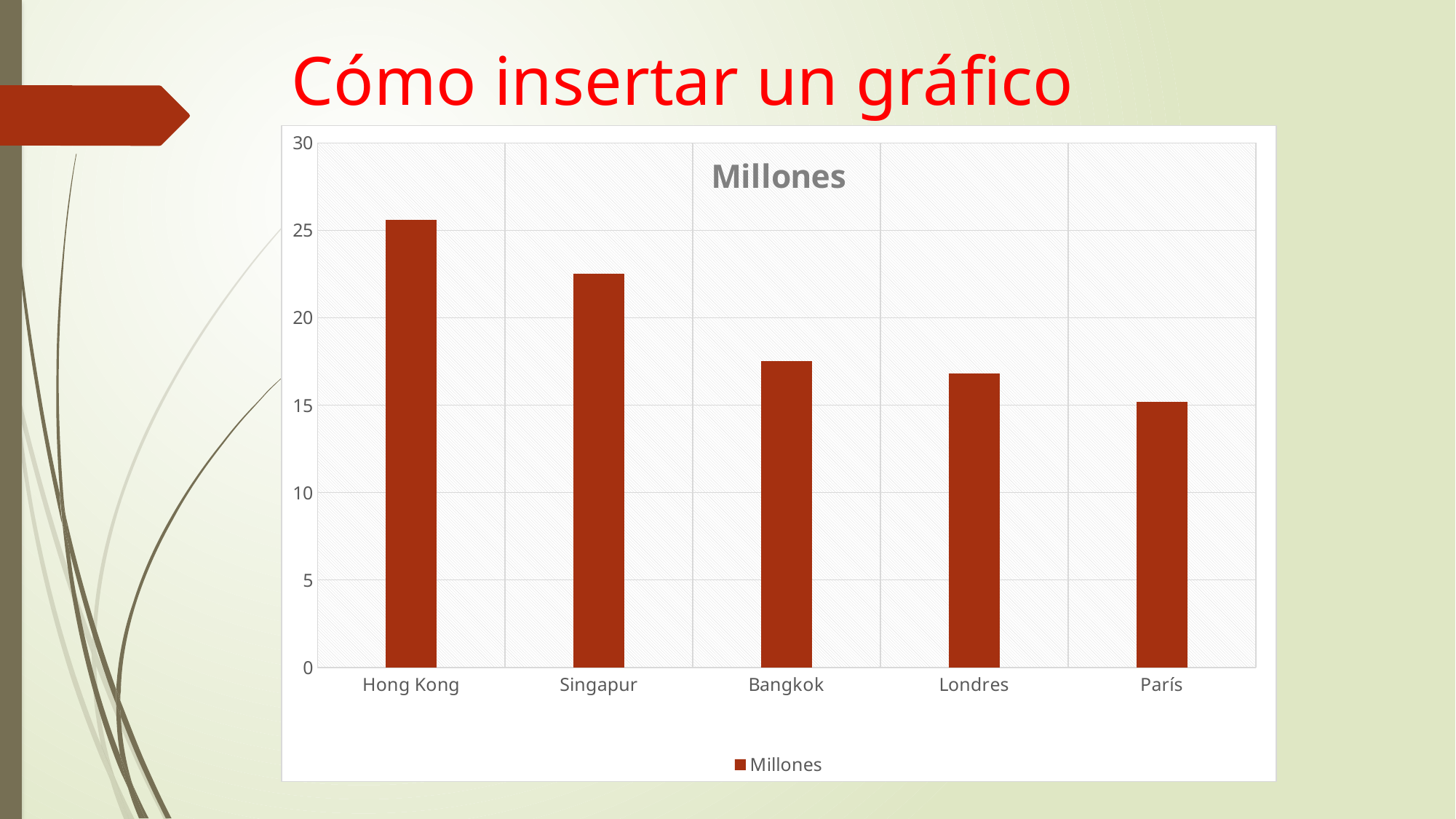
How many series does the chart's legend list? 1 Which has a larger value, Singapur or París? Singapur Do the values rise or fall from Hong Kong to París along the x axis? fall Which has a larger value, Hong Kong or Singapur? Hong Kong Which city has the highest value in the chart? Hong Kong What is the title of the chart? Millones Is the value for Bangkok greater or less than 20? less How many categories are shown on the x axis of the chart? 5 Which city has the lowest value in the chart? París Is the value for Hong Kong greater or less than 25? greater What kind of chart is shown on the slide? bar chart